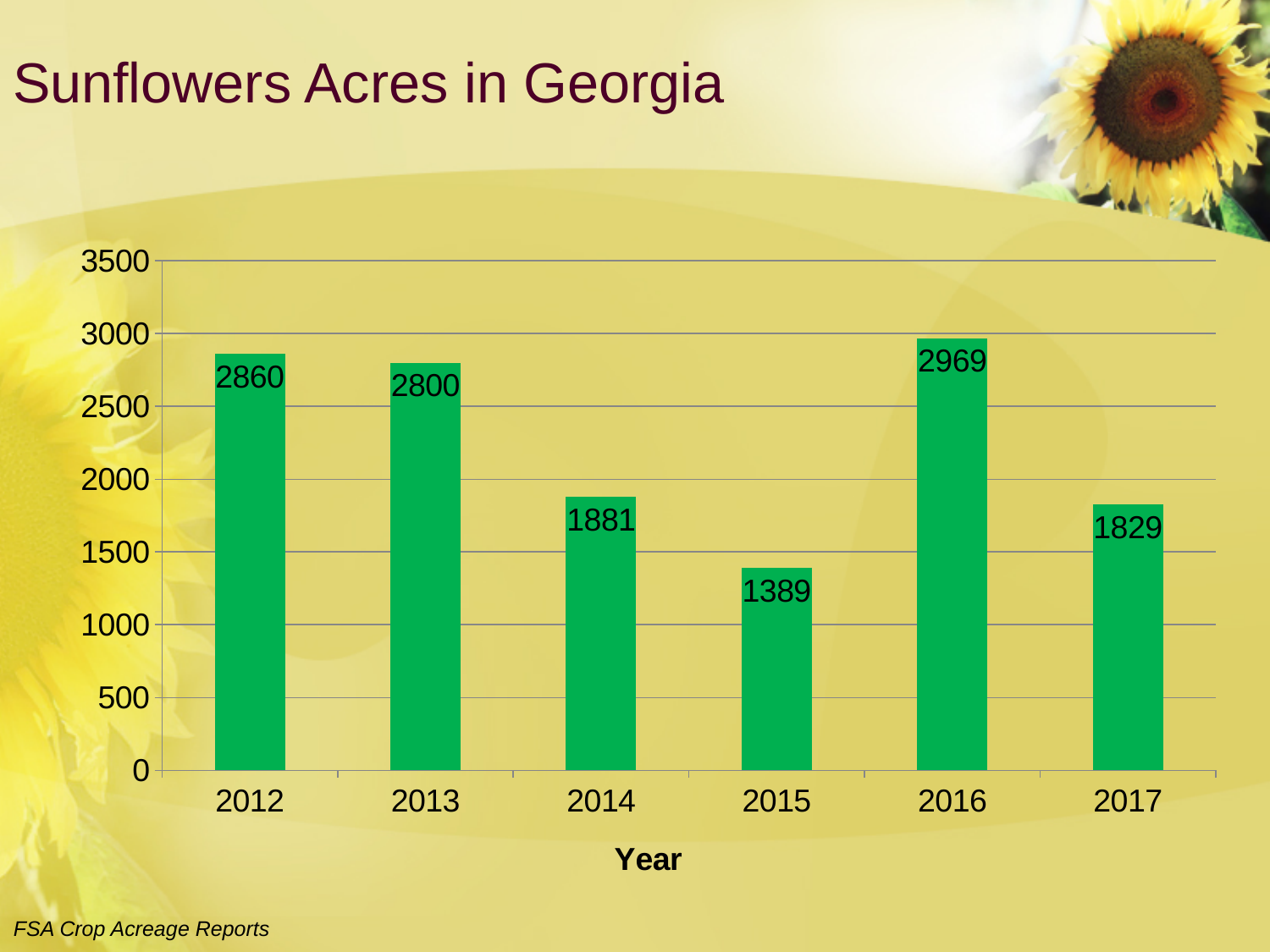
How many years are shown on the x axis? 6 Is the value for 2013 greater or less than 2500? greater What is the title of the slide? Sunflowers Acres in Georgia What is the difference between the values for 2016 and 2015? 1580 What is the value for 2012? 2860 Which is larger, the value for 2014 or the value for 2017? 2014 Which year has the highest value? 2016 What is the difference between the values for 2012 and 2013? 60 What is the value for 2017? 1829 What is the value for 2015? 1389 Which year has the lowest value? 2015 What kind of chart is shown on the slide? bar chart